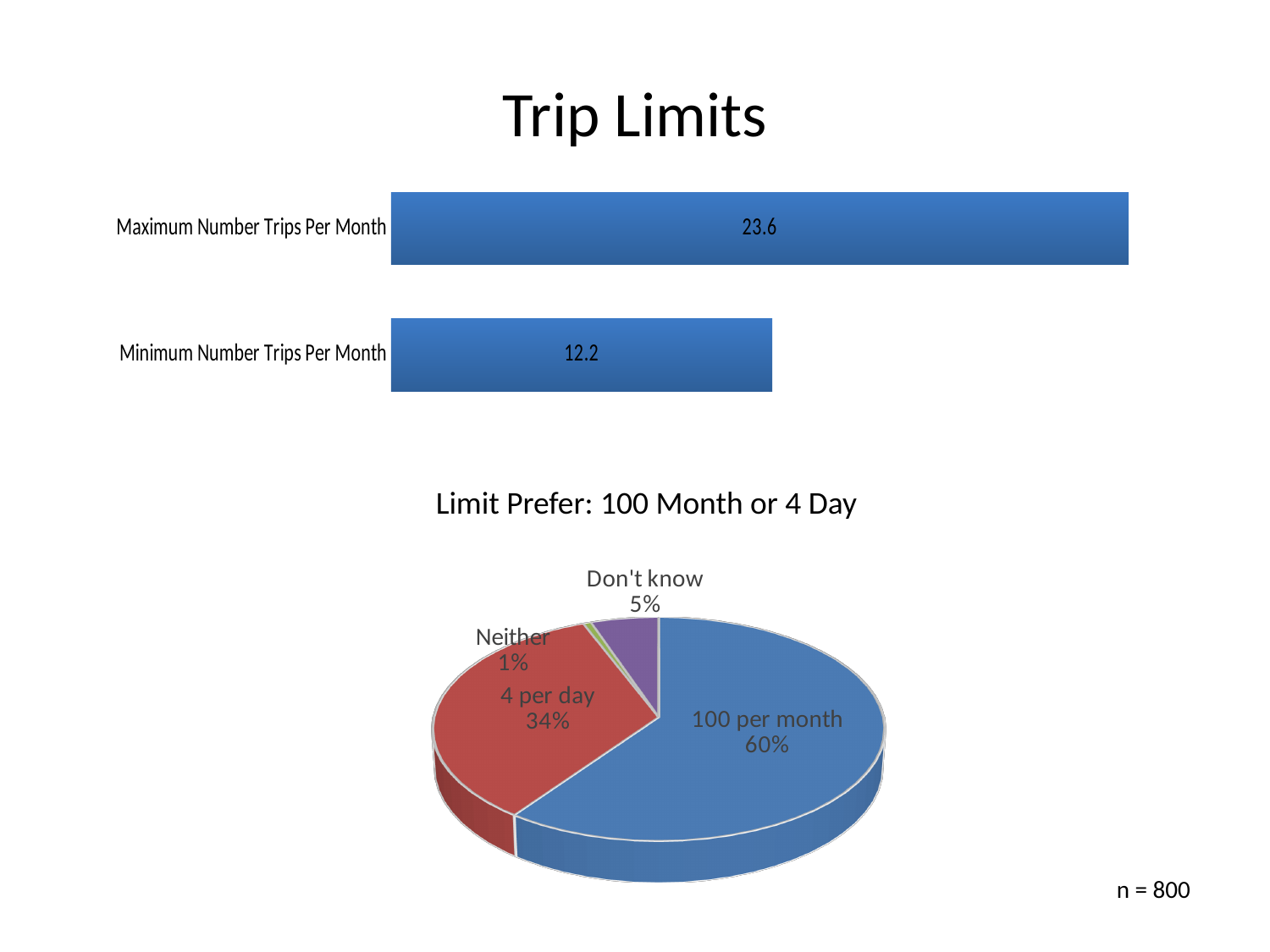
In the bar chart at the top of the slide, what is the value for Minimum Number Trips Per Month? 12.2 In the bar chart at the top of the slide, what is the difference between the Maximum and Minimum Number Trips Per Month? 11.4 In the bar chart at the top of the slide, what is the value for Maximum Number Trips Per Month? 23.6 In the pie chart 'Limit Prefer: 100 Month or 4 Day', what is the difference between the 100 per month share and the 4 per day share? 26% In the bar chart at the top of the slide, which category has the higher value? Maximum Number Trips Per Month In the pie chart 'Limit Prefer: 100 Month or 4 Day', what share is 4 per day? 34% In the pie chart 'Limit Prefer: 100 Month or 4 Day', which slice is the smallest? Neither What kind of chart is the top chart on the slide? Bar chart In the pie chart 'Limit Prefer: 100 Month or 4 Day', how many slices are there? 4 In the pie chart 'Limit Prefer: 100 Month or 4 Day', which slice is the largest? 100 per month In the pie chart 'Limit Prefer: 100 Month or 4 Day', what share is 100 per month? 60% In the bar chart at the top of the slide, how many categories are shown? 2